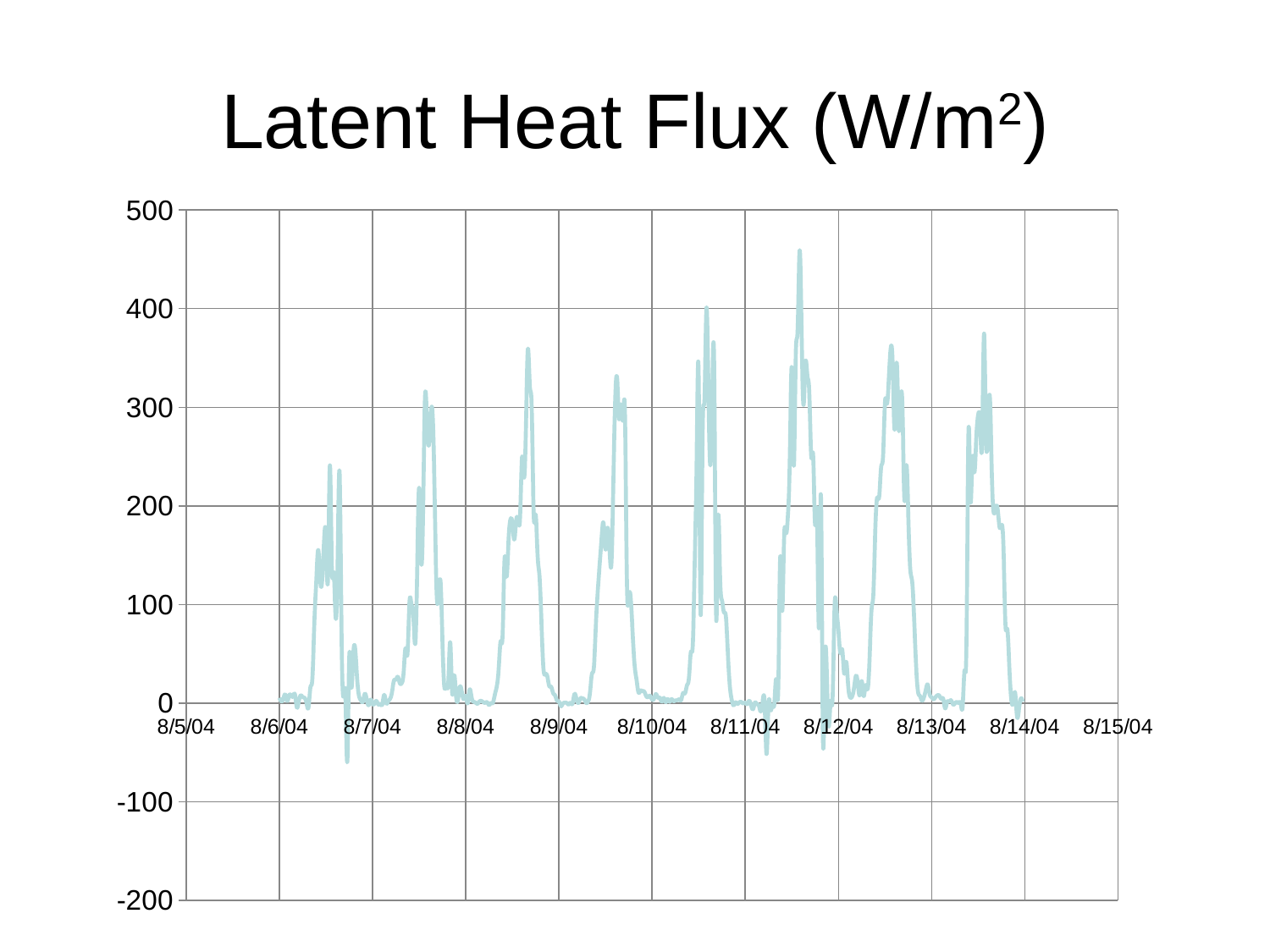
Is the peak of the latent heat flux between 8/12/04 and 8/13/04 greater or less than 400? less What kind of chart is shown on the slide? line chart What is the title of the chart? Latent Heat Flux (W/m2) Is the highest peak of the latent heat flux, between 8/11/04 and 8/12/04, greater or less than 400? greater Does the latent heat flux ever drop below 0 on the chart? yes What is the lowest value shown on the vertical axis? -200 What is the highest value shown on the vertical axis? 500 Which daily peak is higher: the one between 8/6/04 and 8/7/04 or the one between 8/11/04 and 8/12/04? 8/11/04 and 8/12/04 Between which two date labels does the latent heat flux reach its highest peak? 8/11/04 and 8/12/04 How many date labels are shown along the horizontal axis? 11